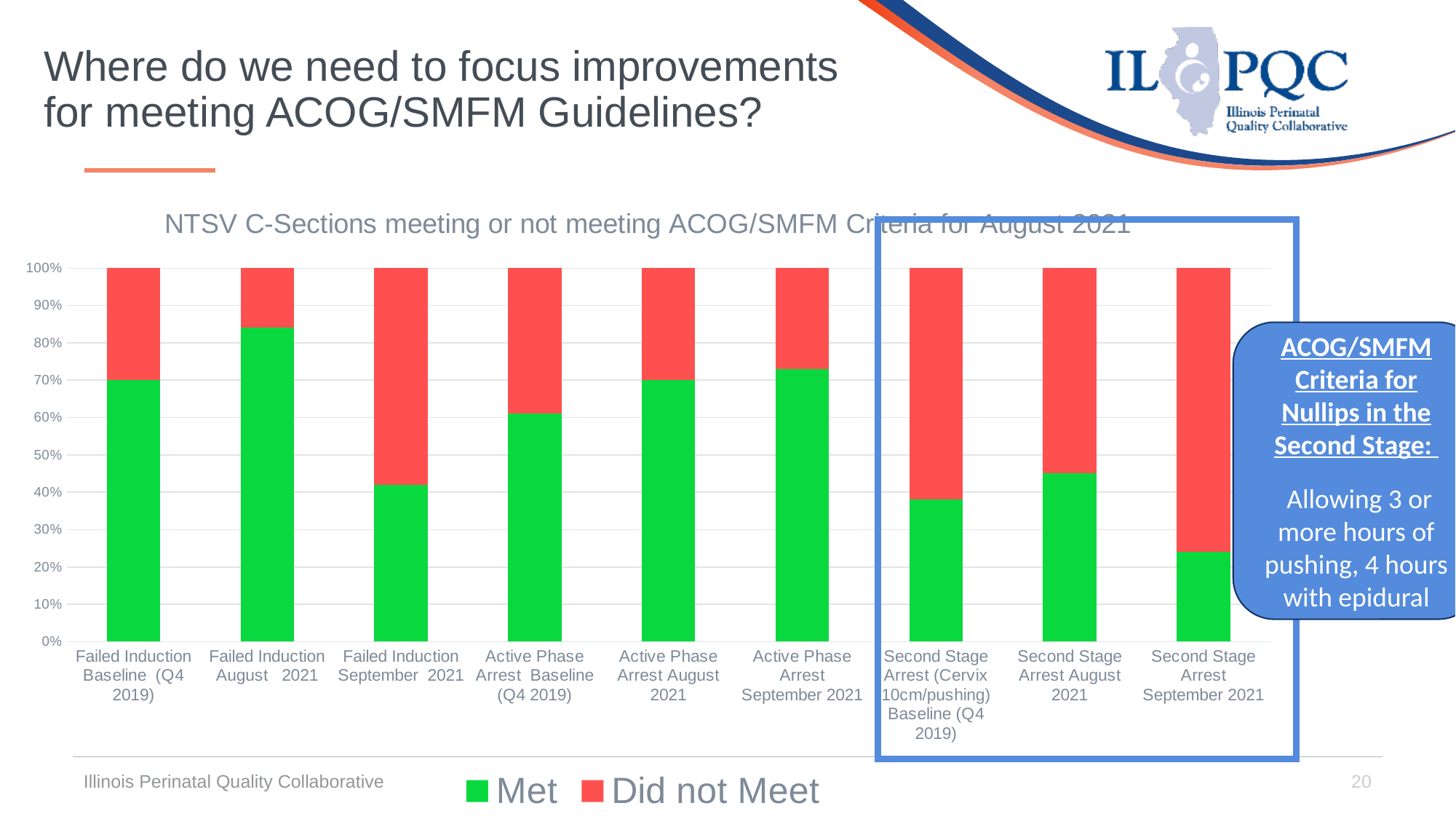
How many series does the chart legend list? 2 How many categories are shown on the x axis of the chart? 9 Is the 'Met' value for Second Stage Arrest September 2021 greater or less than 30%? less Which category has the lowest 'Met' share? Second Stage Arrest September 2021 What kind of chart is shown on the slide? Stacked bar chart Which category has the highest 'Met' share? Failed Induction August 2021 Is the 'Met' value for Active Phase Arrest Baseline (Q4 2019) greater or less than 50%? greater Is the 'Met' value for Failed Induction August 2021 greater or less than 80%? greater Which has a larger 'Met' share: Second Stage Arrest August 2021 or Second Stage Arrest September 2021? Second Stage Arrest August 2021 What is the title of the chart? NTSV C-Sections meeting or not meeting ACOG/SMFM Criteria for August 2021 Which colour represents the 'Did not Meet' series in the chart? Red